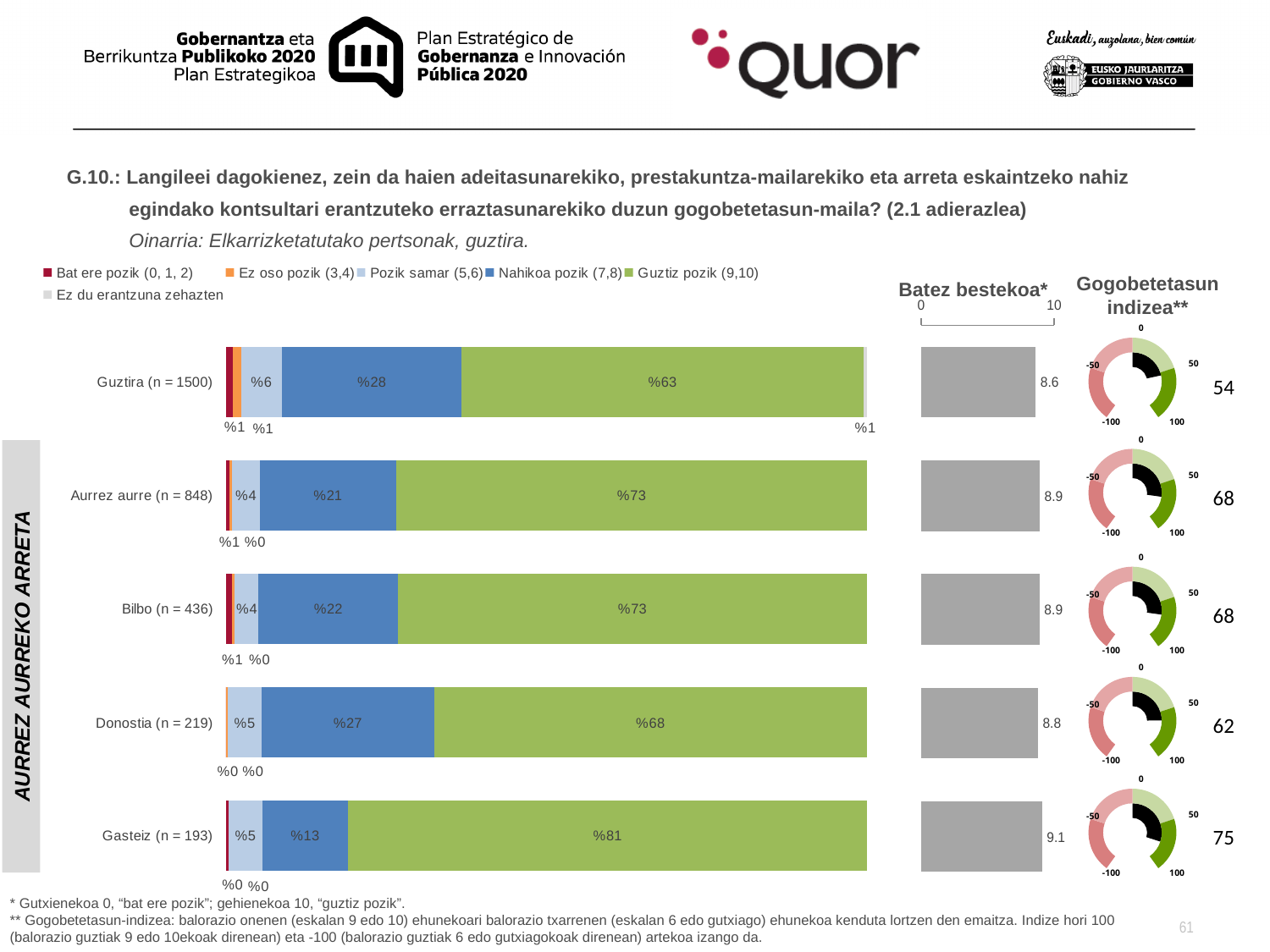
How many categories (rows) are shown in the stacked bar chart? 5 In the stacked bar chart, what percentage of Donostia (n = 219) respondents are 'Pozik samar (5,6)'? %5 How many series does the legend of the stacked bar chart list? 6 In the stacked bar chart, what percentage of Guztira (n = 1500) respondents are 'Nahikoa pozik (7,8)'? %28 In the 'Gogobetetasun indizea**' gauges, what is the index value for Donostia (n = 219)? 62 In the stacked bar chart, which category has the highest 'Guztiz pozik (9,10)' share? Gasteiz (n = 193) In the stacked bar chart, what percentage of Gasteiz (n = 193) respondents are 'Guztiz pozik (9,10)'? %81 In the stacked bar chart, what is the difference between the 'Guztiz pozik (9,10)' shares of Gasteiz (n = 193) and Guztira (n = 1500)? 18 percentage points In the stacked bar chart, is the 'Nahikoa pozik (7,8)' share larger for Donostia (n = 219) or for Gasteiz (n = 193)? Donostia (n = 219) In the stacked bar chart, which category has the lowest 'Guztiz pozik (9,10)' share? Guztira (n = 1500) In the 'Batez bestekoa*' chart, what is the average score for Gasteiz (n = 193)? 9.1 In the 'Batez bestekoa*' chart, which category has the lowest average score? Guztira (n = 1500)